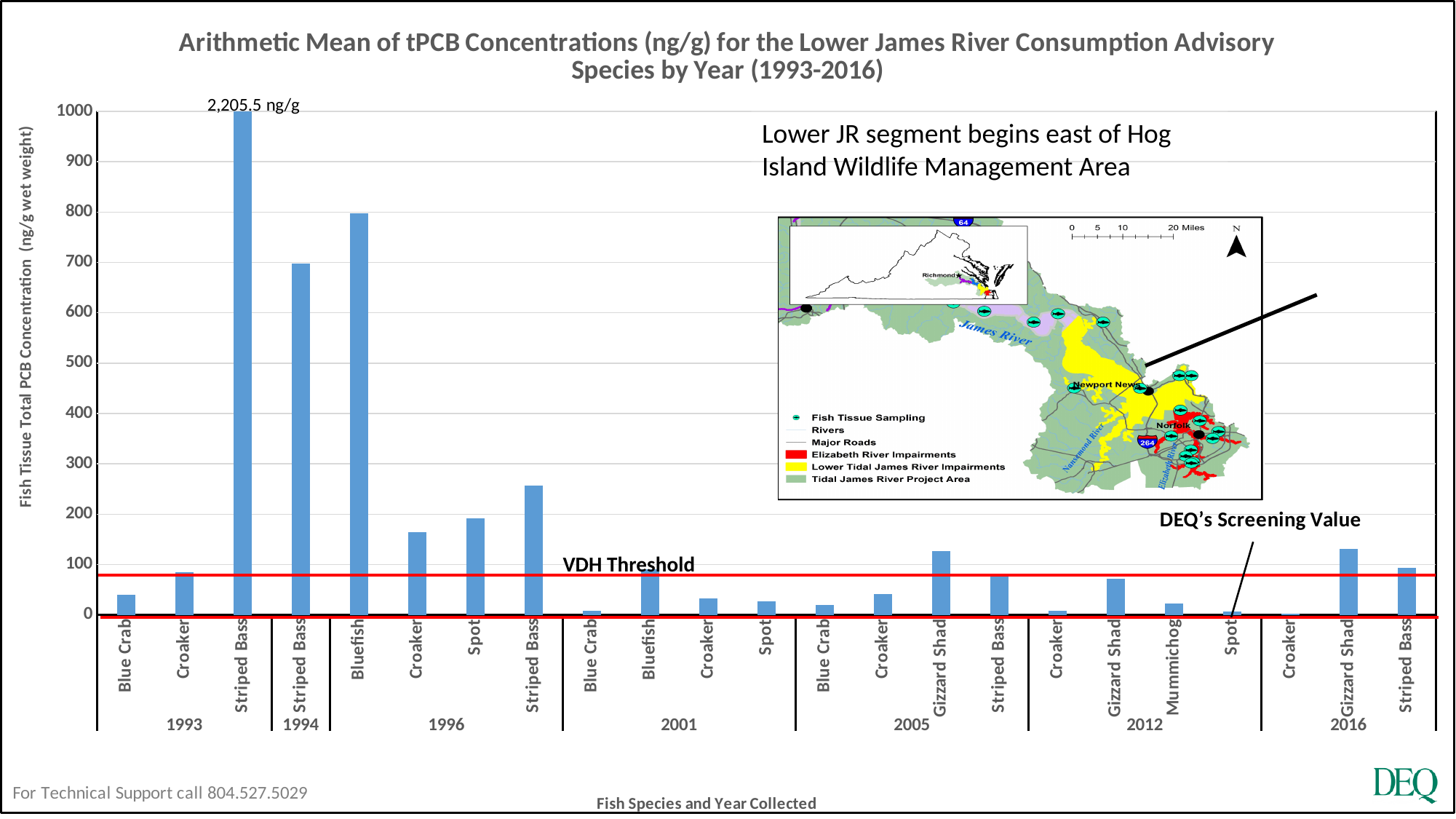
Is the value for Bluefish in 1996 greater or less than 700? greater What are the two labeled horizontal reference lines on the chart? VDH Threshold and DEQ's Screening Value Is the value for Striped Bass in 1996 greater or less than 200? greater Which is larger, the value for Bluefish in 1996 or Striped Bass in 1996? Bluefish in 1996 Is the value for Gizzard Shad in 2005 greater or less than 100? greater How many bars (species-year categories) are plotted on the chart? 23 Which species and year has the highest tPCB concentration on the chart? Striped Bass, 1993 What kind of chart is shown on the slide? Bar chart What is the labeled tPCB concentration for Striped Bass in 1993? 2,205.5 ng/g How many year groups are shown along the x axis? 7 Which is larger, the value for Spot in 1996 or Croaker in 1996? Spot in 1996